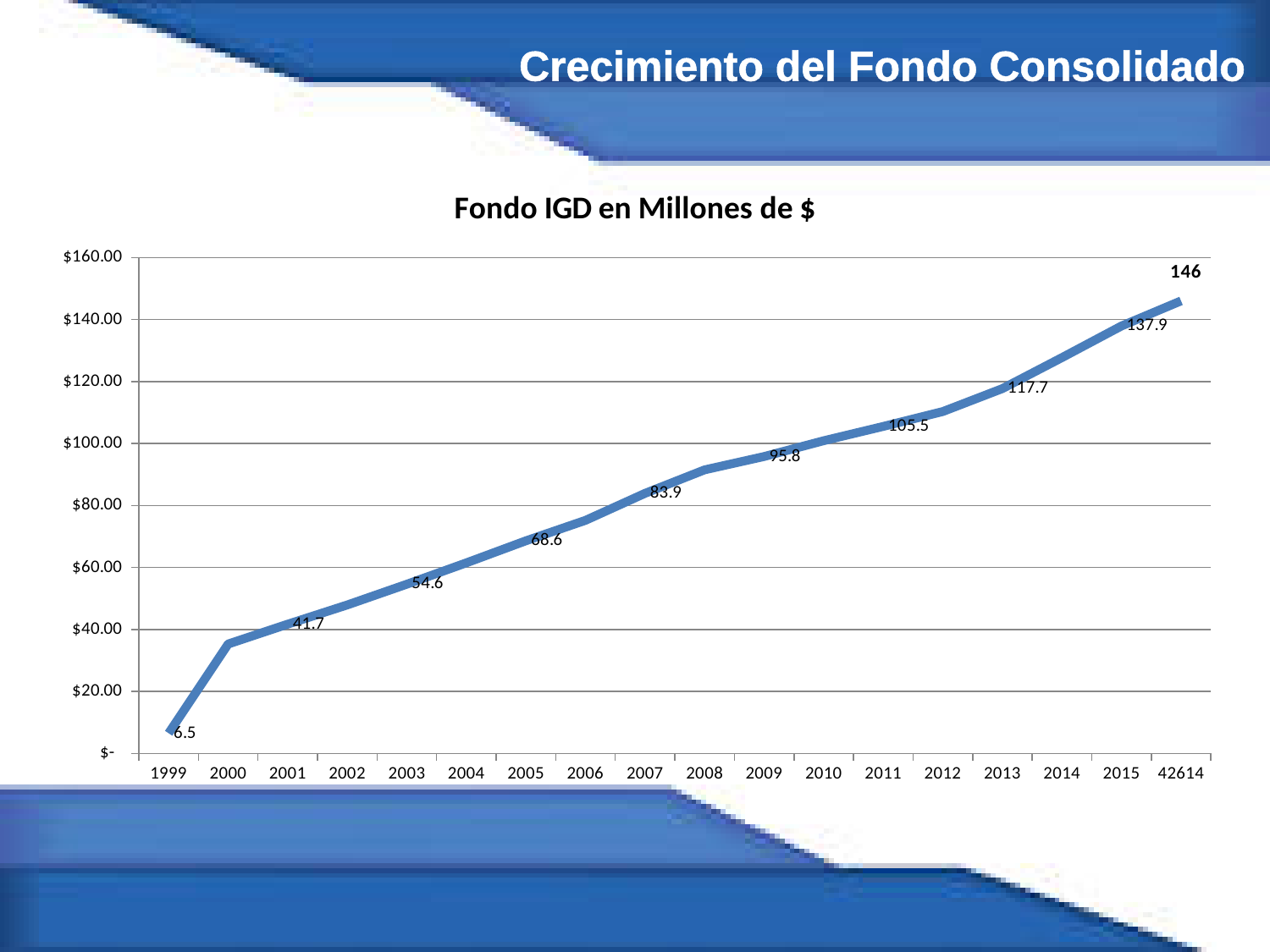
What is the title of the chart? Fondo IGD en Millones de $ How many categories are shown on the x axis? 18 What is the value for 1999? 6.5 What kind of chart is shown on the slide? line chart Which category has the lowest value? 1999 Is the value for 2000 greater or less than $40.00? less What is the difference between the values for 2015 and 2013? 20.2 Which is larger, the value for 2005 or the value for 2009? 2009 What is the value labelled at the last point on the line (category 42614)? 146 What is the value for 2013? 117.7 What is the value for 2007? 83.9 Do the values rise or fall from 1999 to 2015? rise